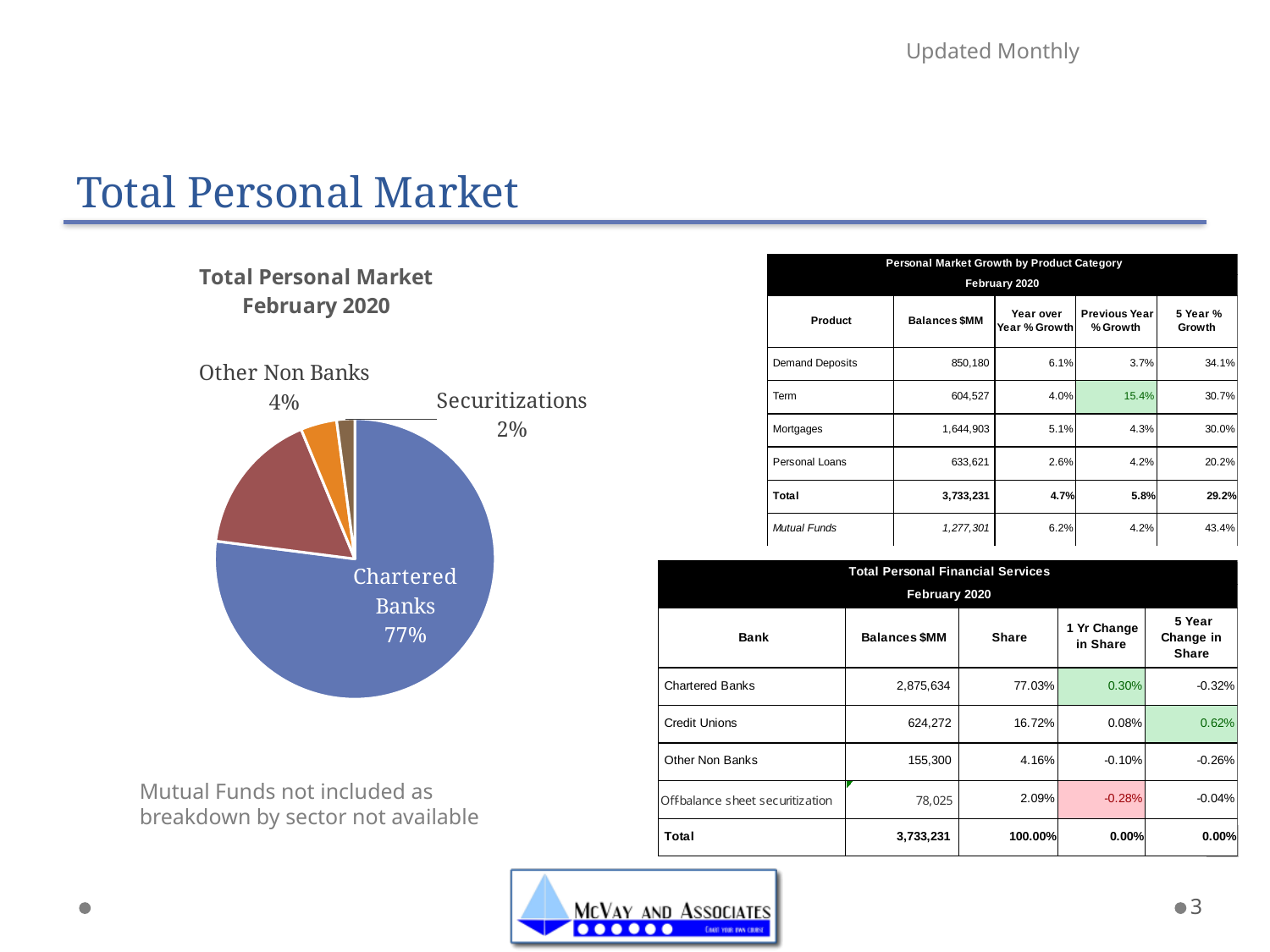
In the pie chart, how many percentage points larger is Chartered Banks than Other Non Banks? 73 percentage points In the pie chart, which is larger: Other Non Banks or Securitizations? Other Non Banks Which slice of the pie chart is the largest? Chartered Banks What share of the pie chart is Securitizations? 2% What share of the pie chart is Chartered Banks? 77% What kind of chart is shown on the left of the slide? pie chart How many slices does the pie chart have? 4 Which slice of the pie chart is the smallest? Securitizations What colour is the Chartered Banks slice in the pie chart? blue In the pie chart, how many percentage points larger is Other Non Banks than Securitizations? 2 percentage points What is the title of the pie chart? Total Personal Market February 2020 What share of the pie chart is Other Non Banks? 4%